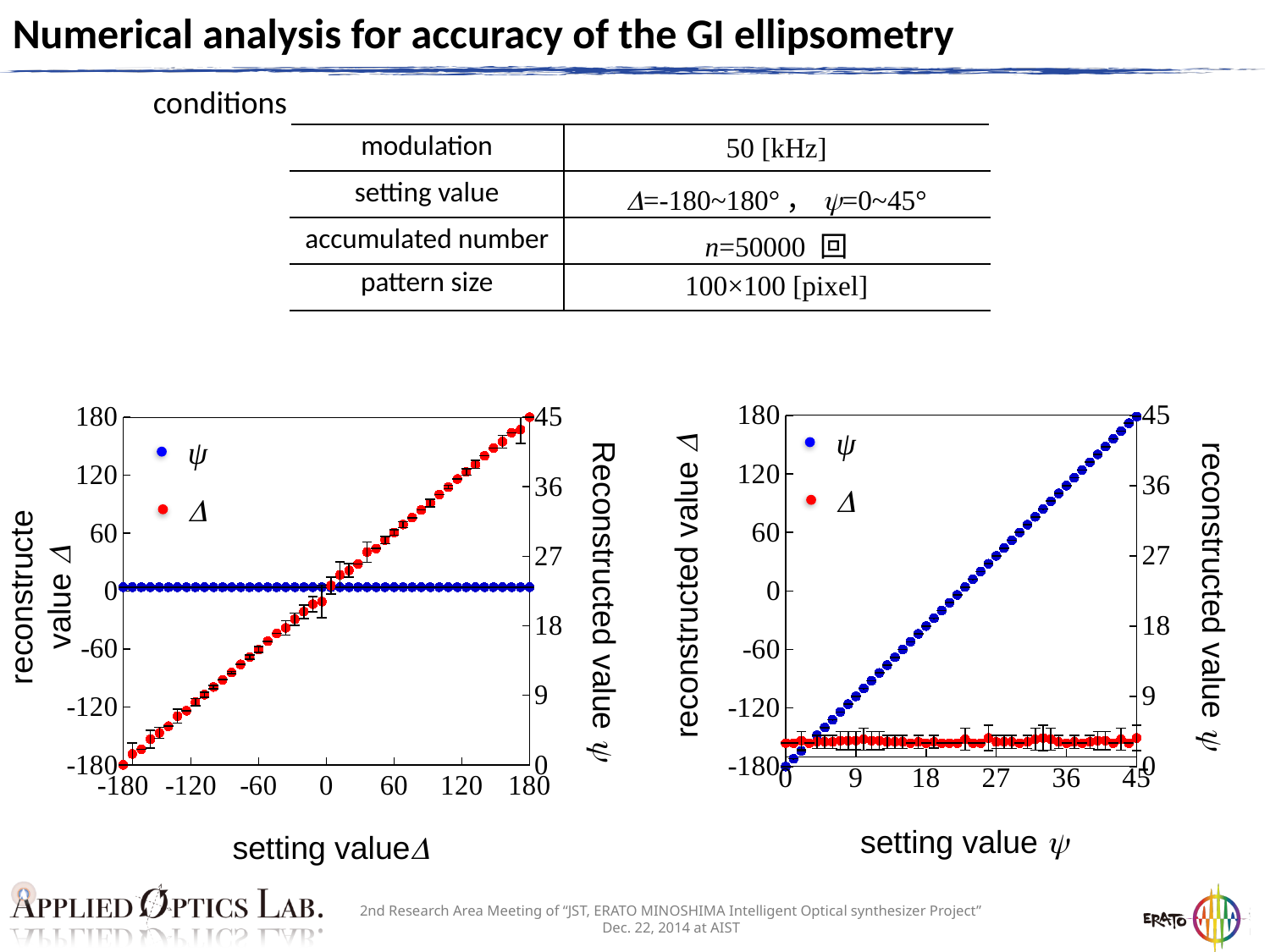
What colour are the ψ series markers in both charts? blue In the left chart, is the reconstructed value Δ at setting value Δ = 180 greater or less than 120? greater What kind of chart is the right chart (setting value ψ on the x axis)? scatter chart In the right chart, is the reconstructed value ψ (right axis) at setting value ψ = 45 greater or less than 36? greater How many series does the legend of the left chart list? 2 What is the x-axis label of the right chart? setting value ψ What kind of chart is the left chart (setting value Δ on the x axis)? scatter chart How many series does the legend of the right chart list? 2 In the left chart, does the red Δ series rise or fall as the setting value Δ increases from -180 to 180? rise In the left chart, is the reconstructed value Δ at setting value Δ = -180 greater or less than -120? less In the right chart, does the blue ψ series rise or fall as the setting value ψ increases from 0 to 45? rise